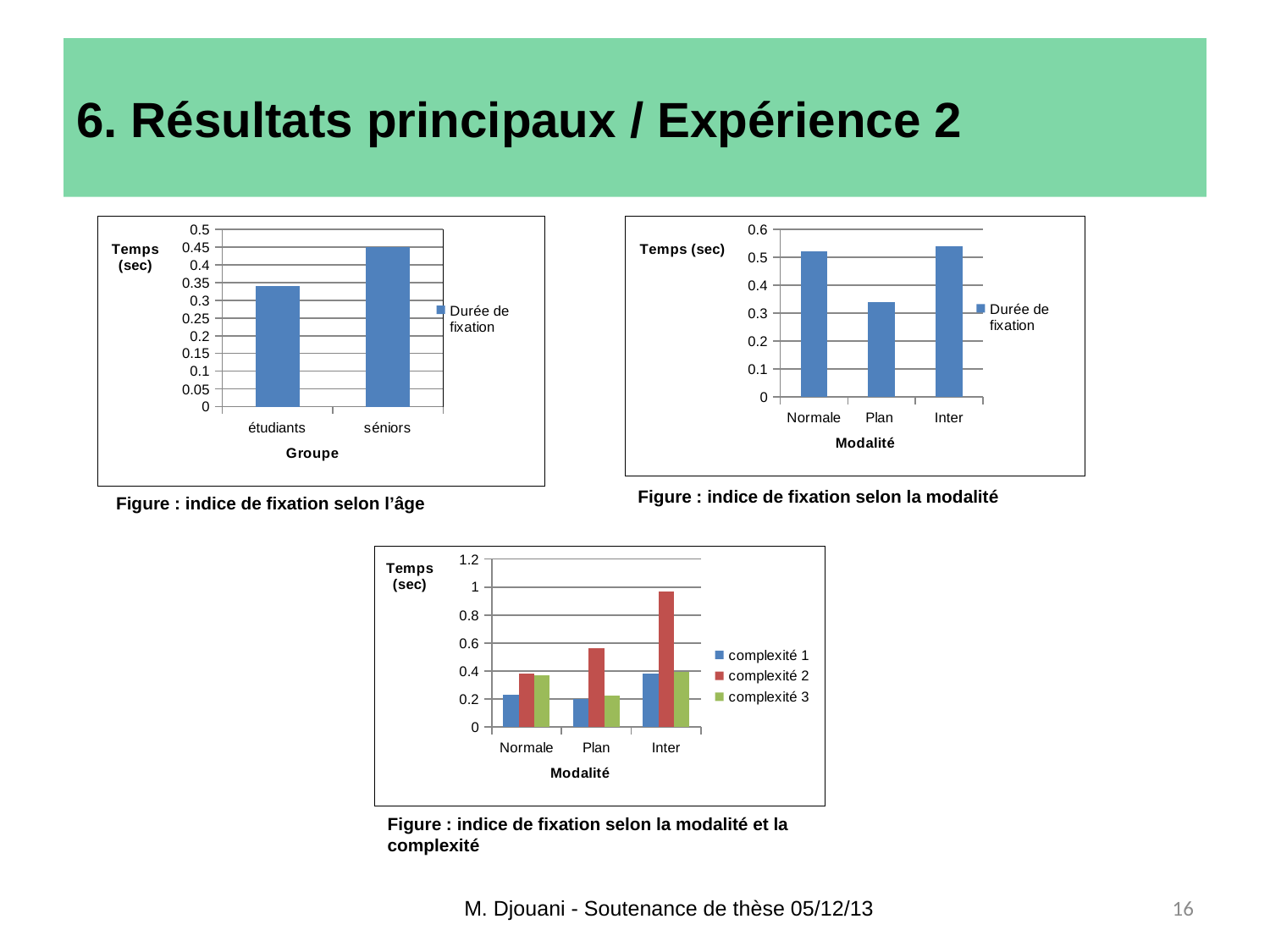
In the chart titled 'Figure : indice de fixation selon la modalité', is the value for Plan greater or less than 0.4? less In the chart titled 'Figure : indice de fixation selon l'âge', which group has the higher fixation duration? séniors In the chart titled 'Figure : indice de fixation selon la modalité et la complexité', which is larger at Plan: complexité 1 or complexité 2? complexité 2 In the chart titled 'Figure : indice de fixation selon l'âge', is the value for séniors greater or less than 0.4? greater In the chart titled 'Figure : indice de fixation selon la modalité et la complexité', is the value for complexité 2 at Inter greater or less than 0.8? greater In the chart titled 'Figure : indice de fixation selon la modalité et la complexité', which modality has the highest value for complexité 2? Inter How many groups are shown on the x axis of the chart titled 'Figure : indice de fixation selon l'âge'? 2 What kind of chart is the chart titled 'Figure : indice de fixation selon la modalité'? bar chart In the chart titled 'Figure : indice de fixation selon la modalité', which modality has the lowest fixation duration? Plan How many series does the legend list in the chart titled 'Figure : indice de fixation selon la modalité et la complexité'? 3